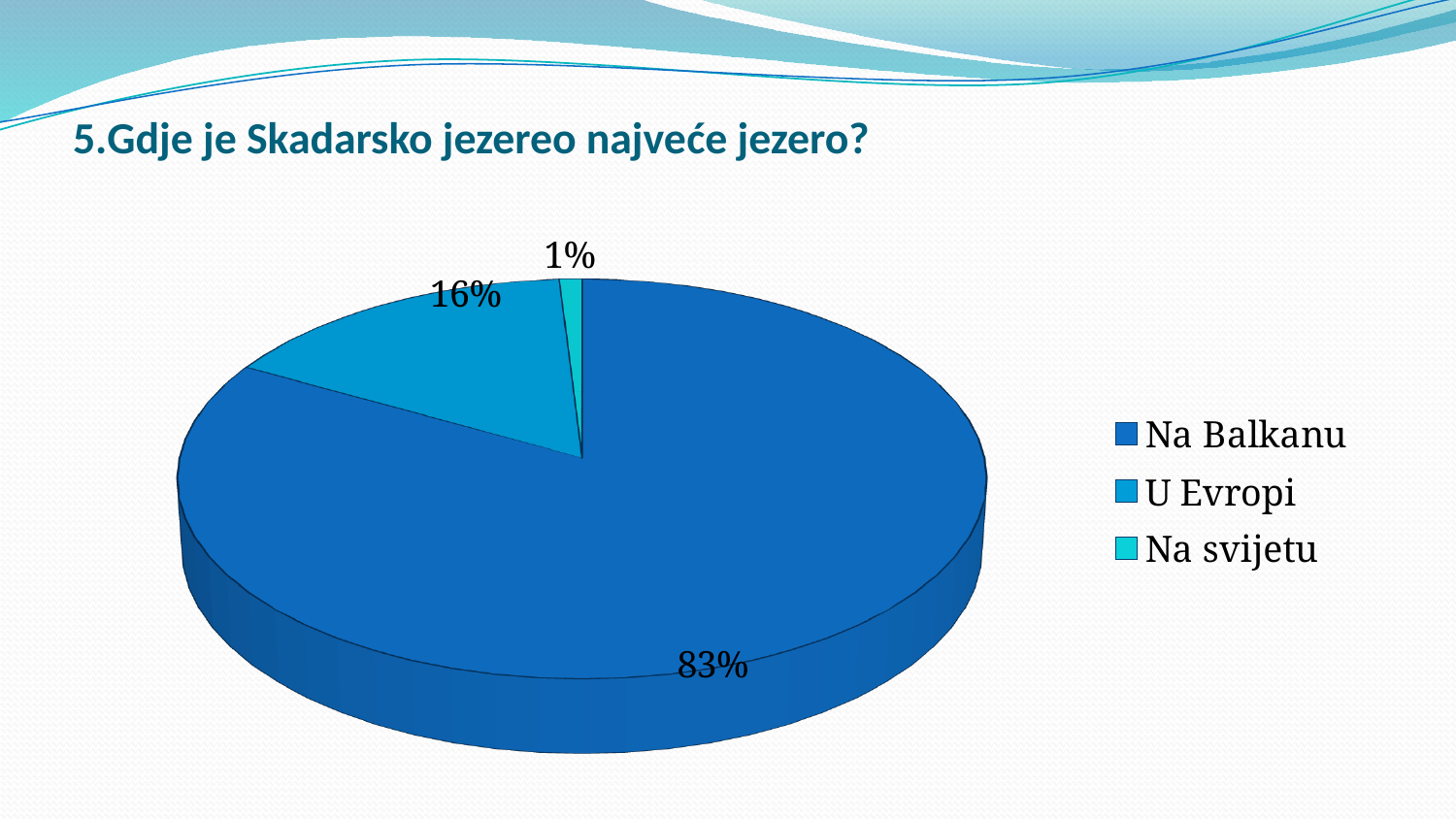
Which is larger, the slice for "U Evropi" or the slice for "Na svijetu"? U Evropi What share of the pie does "Na svijetu" have? 1% How many entries does the legend list? 3 What is the difference in percentage points between "Na Balkanu" and "U Evropi"? 67 What share of the pie does "Na Balkanu" have? 83% What is the title of the question shown above the chart? 5.Gdje je Skadarsko jezereo najveće jezero? What kind of chart is shown on the slide? pie chart Which category has the largest slice of the pie? Na Balkanu How many categories does the pie chart have? 3 What is the difference in percentage points between "U Evropi" and "Na svijetu"? 15 Which category has the smallest slice of the pie? Na svijetu What share of the pie does "U Evropi" have? 16%